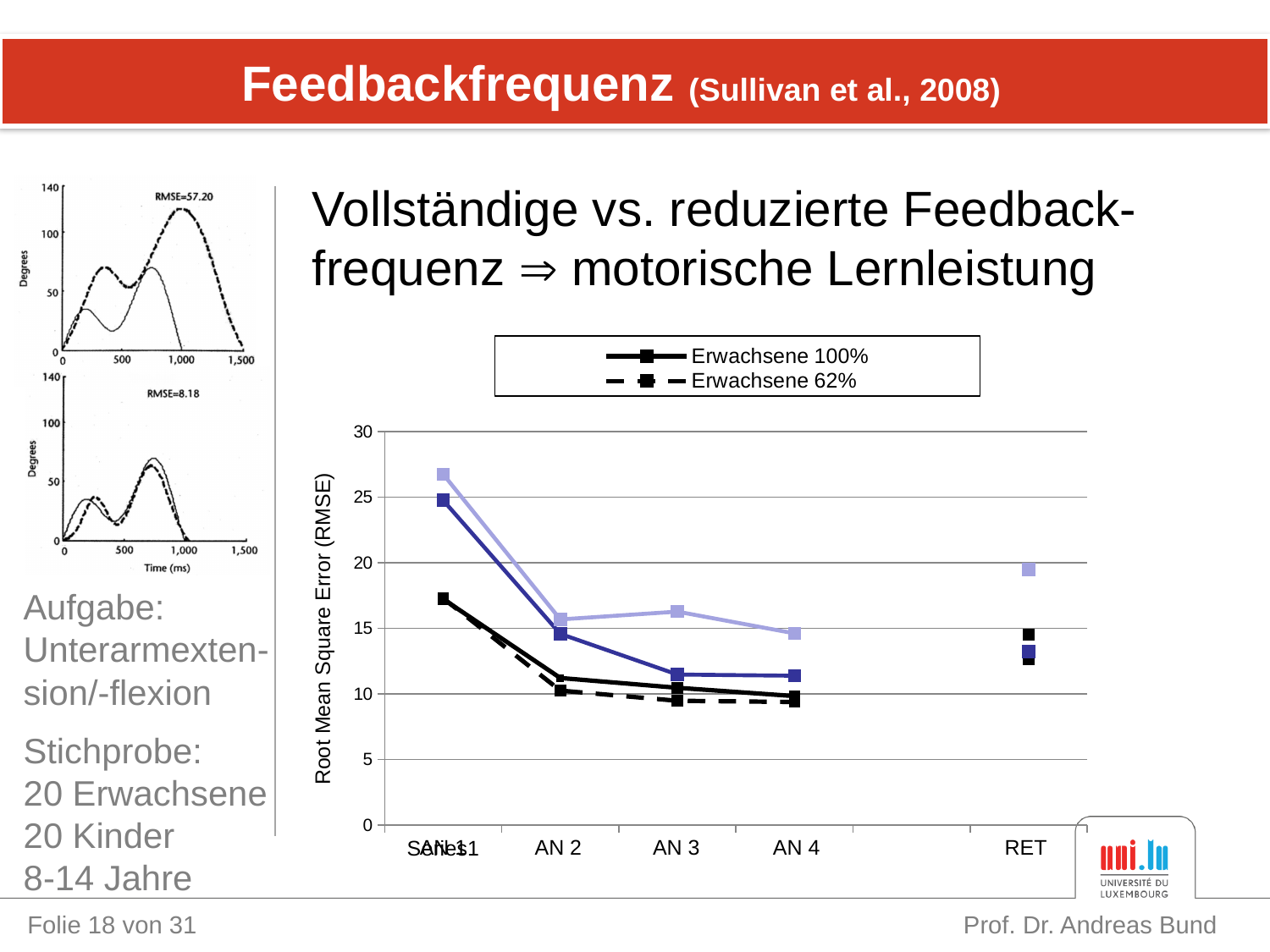
In the large line chart, is the value for Erwachsene 100% at AN 4 greater or less than 15? less What RMSE value is printed on the bottom small chart on the left of the slide? RMSE=8.18 In the large line chart, which legend entry is drawn with a dashed line? Erwachsene 62% In the large line chart, is the value for Erwachsene 62% at AN 3 greater or less than 15? less In the large line chart, is the value for Erwachsene 100% at RET greater or less than 10? greater What is the y-axis title of the large line chart? Root Mean Square Error (RMSE) What kind of chart is the large chart on the right of the slide? line chart In the large line chart, which is larger for Erwachsene 100%: the value at AN 2 or the value at RET? RET In the large line chart, does the Erwachsene 100% line rise or fall from the first category to AN 4? fall What RMSE value is printed on the top small chart on the left of the slide? RMSE=57.20 How many series does the legend of the large line chart list? 2